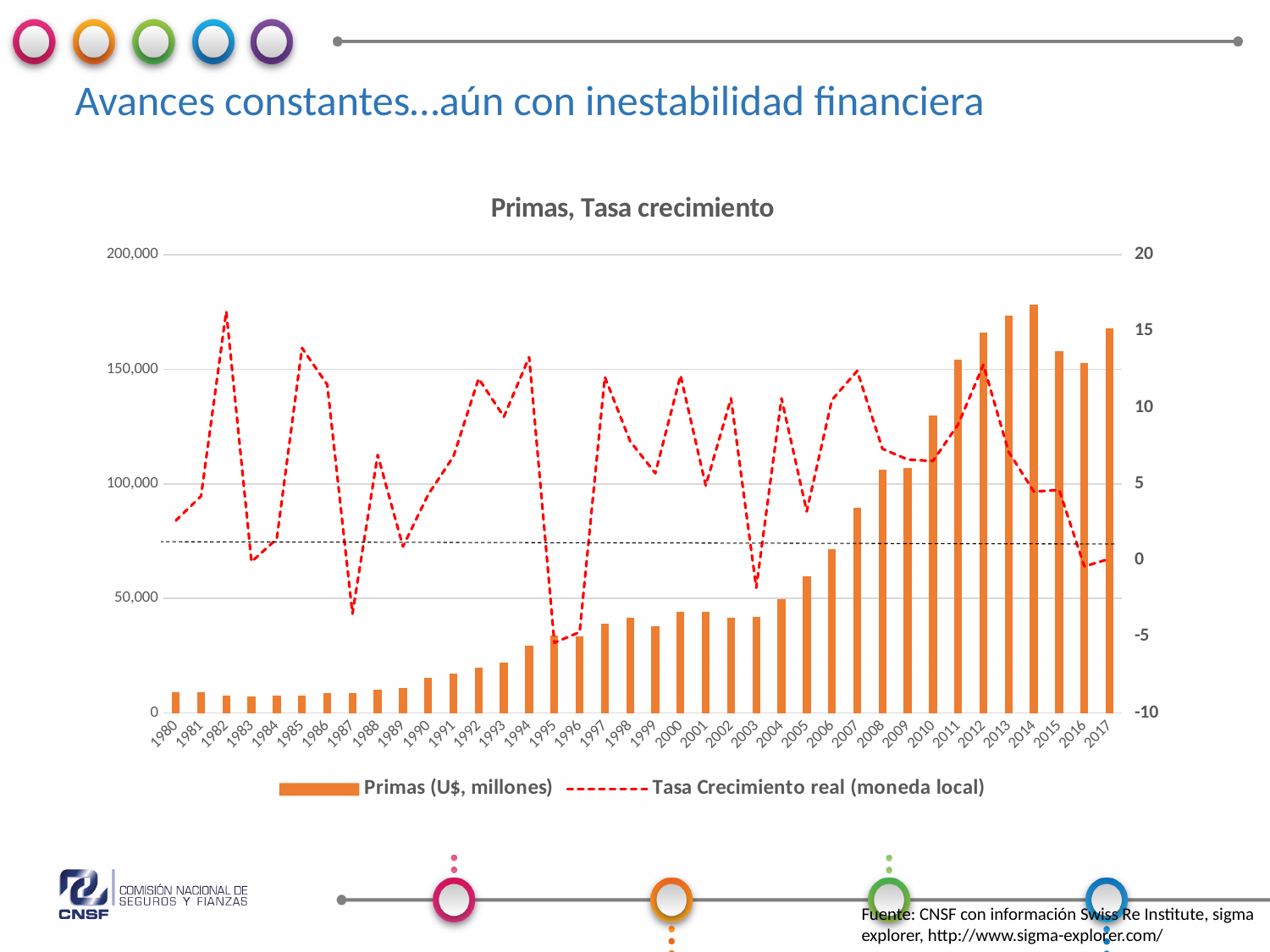
Is the Primas (U$, millones) value for 2005 greater or less than 50,000? greater In which year is the Primas (U$, millones) bar the highest? 2014 What kind of chart is shown on the slide? A combined bar and line chart How many series does the legend list? 2 Do the Primas (U$, millones) bars generally rise or fall from 1980 to 2017? rise What is the title of the chart? Primas, Tasa crecimiento How many years are shown along the x axis? 38 In which year does the Tasa Crecimiento real (moneda local) line reach its highest point? 1982 Which year has the larger Primas (U$, millones) bar, 2016 or 2017? 2017 What colour is the Tasa Crecimiento real (moneda local) line? Red (dashed) Is the Primas (U$, millones) value for 2014 greater or less than 150,000? greater Is the Primas (U$, millones) value for 2010 greater or less than 150,000? less